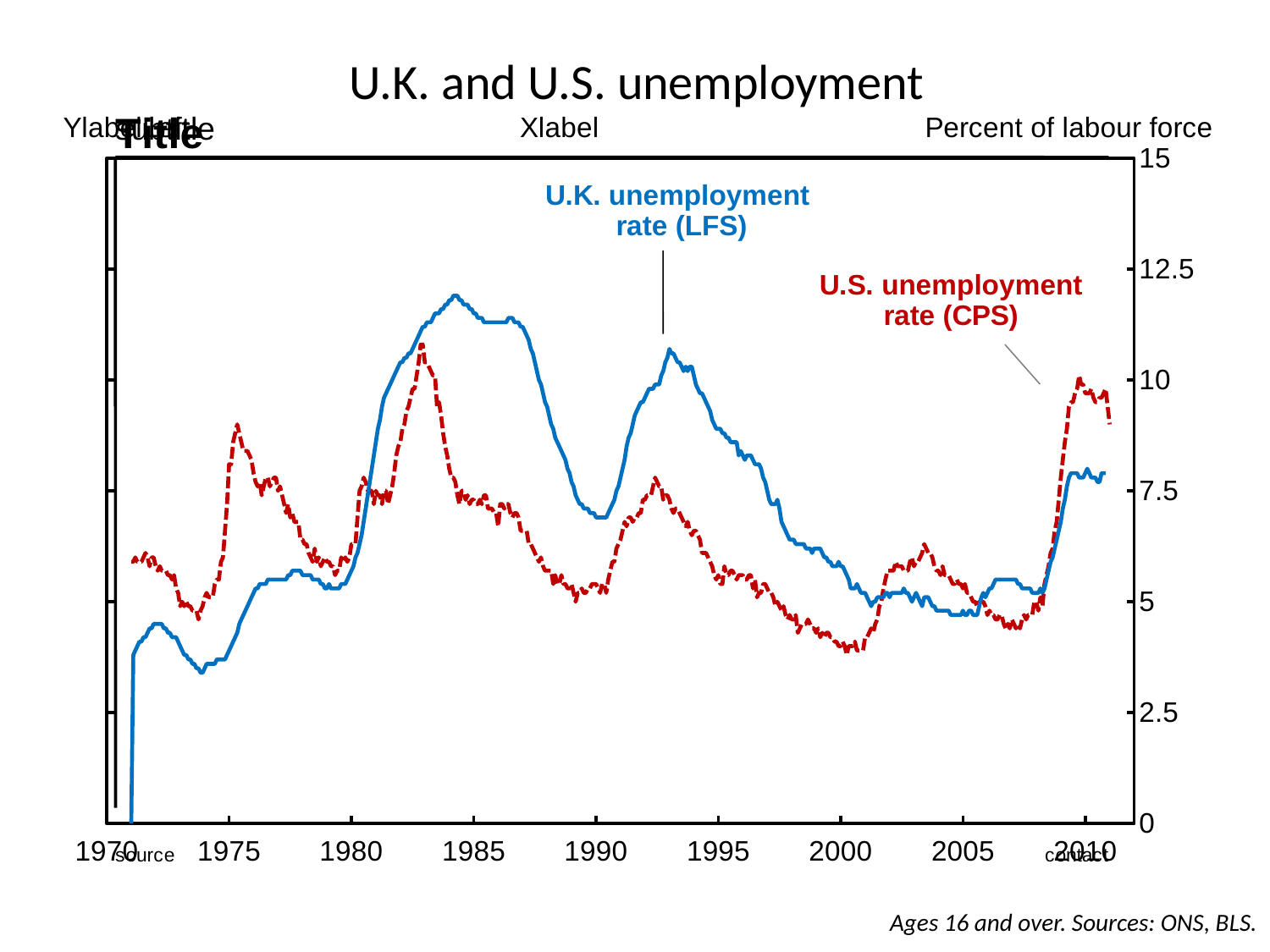
Around 1984, which series has the higher value, the U.K. unemployment rate (LFS) or the U.S. unemployment rate (CPS)? U.K. unemployment rate (LFS) How many series are plotted on the chart? 2 Is the U.K. unemployment rate (LFS) around 2005 greater or less than 7.5? less Around 2010, which series has the higher value, the U.K. unemployment rate (LFS) or the U.S. unemployment rate (CPS)? U.S. unemployment rate (CPS) Which series is drawn as a dashed line? U.S. unemployment rate (CPS) Does the U.K. unemployment rate (LFS) rise or fall between 1993 and 2000? fall What kind of chart is shown on the slide? line chart What is the title of the chart? U.K. and U.S. unemployment Is the U.K. unemployment rate (LFS) around 1973 greater or less than 5? less Is the U.S. unemployment rate (CPS) around 2000 greater or less than 5? less